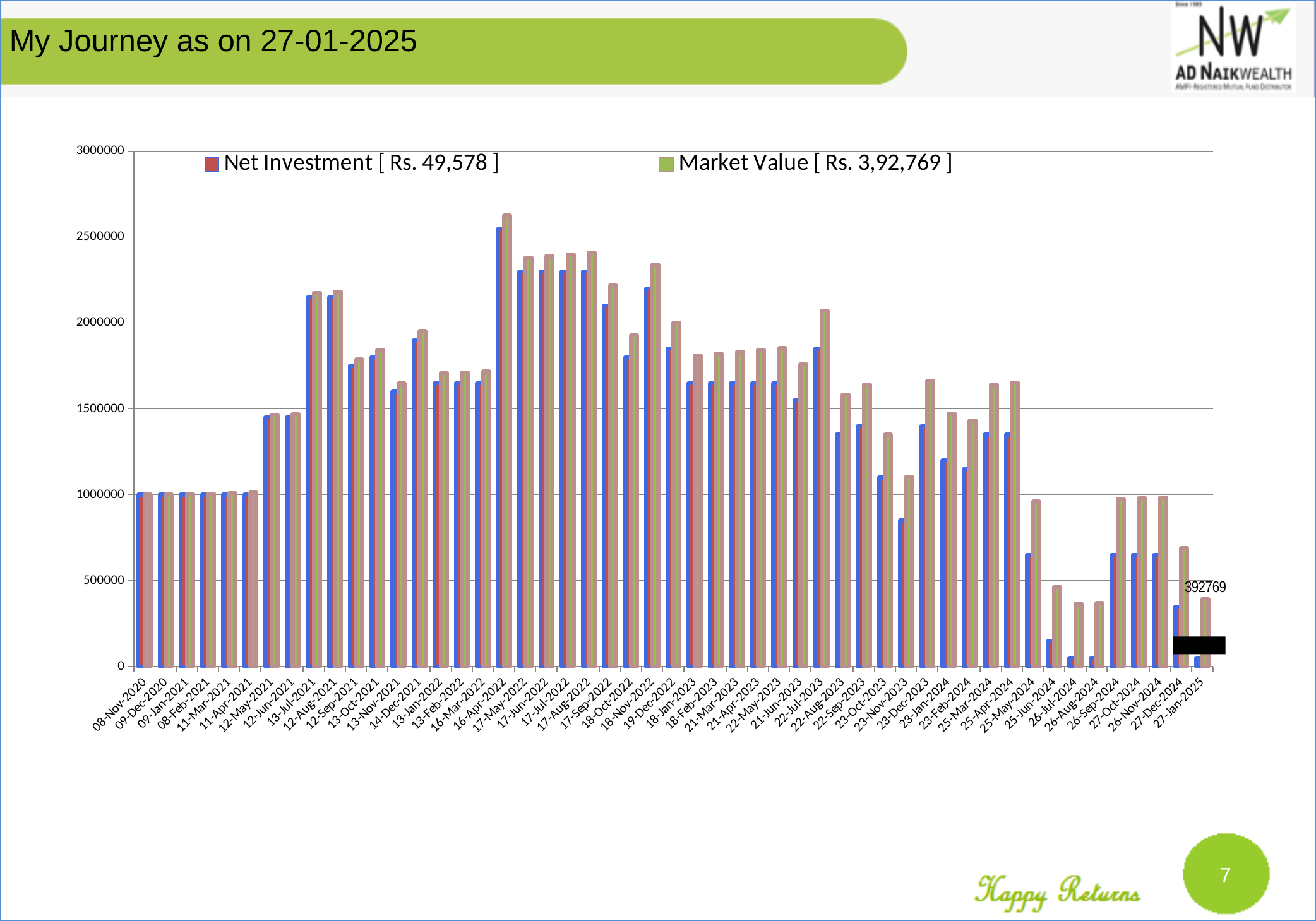
Is the Market Value on 26-Jul-2024 greater or less than 500000? less What amount is shown in the legend entry for Net Investment? Rs. 49,578 What kind of chart is shown on the slide? bar chart What is the Market Value on 27-Jan-2025 according to the data label? 392769 How many series does the legend list? 2 Is the Market Value on 16-Apr-2022 greater or less than 2500000? greater Between 16-Apr-2022 and 17-Sep-2022, does the Net Investment rise or fall? fall On 27-Jan-2025, which is larger: Net Investment or Market Value? Market Value Is the Net Investment on 23-Nov-2023 greater or less than 1000000? less On which date is the Market Value highest? 16-Apr-2022 What is the first date shown on the x axis? 08-Nov-2020 On which date is the Net Investment highest? 16-Apr-2022